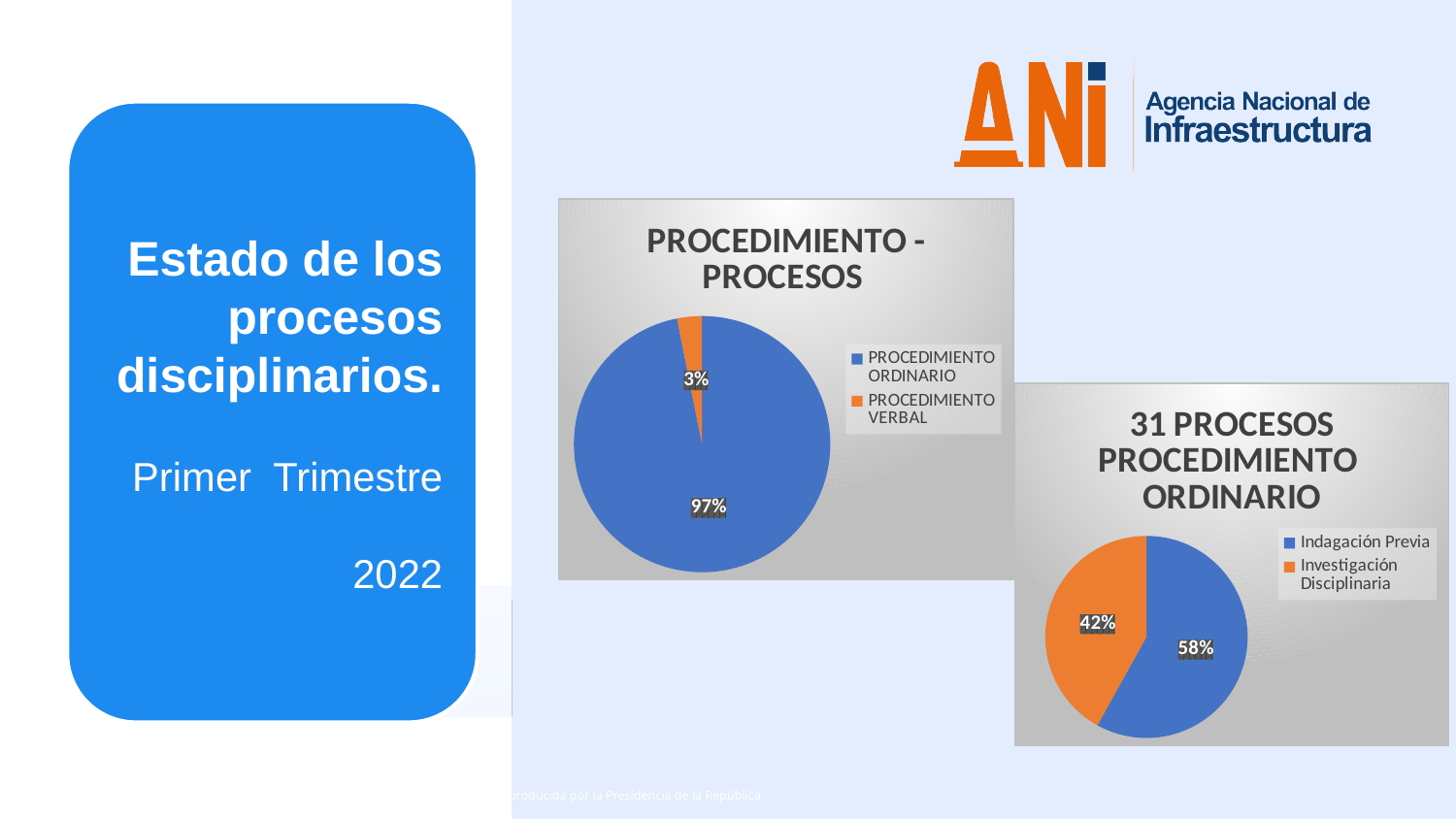
In the '31 PROCESOS PROCEDIMIENTO ORDINARIO' chart, what is the difference in percentage points between Indagación Previa and Investigación Disciplinaria? 16 percentage points How many categories does the legend of the 'PROCEDIMIENTO - PROCESOS' chart list? 2 In the 'PROCEDIMIENTO - PROCESOS' chart, what is the difference in percentage points between PROCEDIMIENTO ORDINARIO and PROCEDIMIENTO VERBAL? 94 percentage points In the '31 PROCESOS PROCEDIMIENTO ORDINARIO' chart, what share does Investigación Disciplinaria have? 42% In the 'PROCEDIMIENTO - PROCESOS' chart, what share does PROCEDIMIENTO VERBAL have? 3% In the 'PROCEDIMIENTO - PROCESOS' chart, which category has the largest slice? PROCEDIMIENTO ORDINARIO In the '31 PROCESOS PROCEDIMIENTO ORDINARIO' chart, which colour represents Indagación Previa? Blue In the '31 PROCESOS PROCEDIMIENTO ORDINARIO' chart, which category has the smaller slice? Investigación Disciplinaria In the 'PROCEDIMIENTO - PROCESOS' chart, what share does PROCEDIMIENTO ORDINARIO have? 97% How many charts are shown on the slide? 2 What kind of chart is the 'PROCEDIMIENTO - PROCESOS' chart? Pie chart